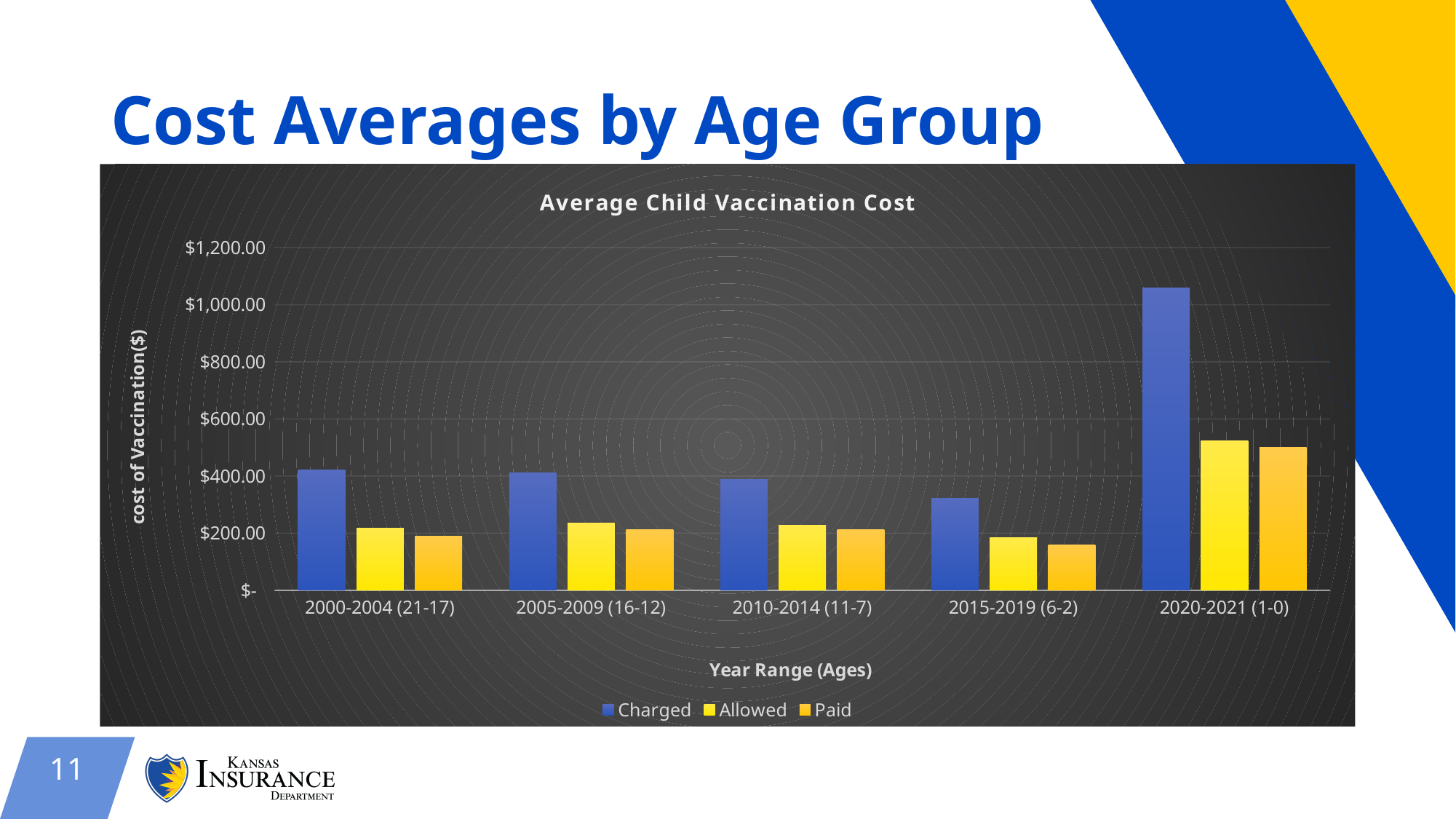
Is the Charged value for 2020-2021 (1-0) greater or less than $1,000.00? greater How many year-range categories are shown on the x axis? 5 Do the Charged values rise or fall from 2000-2004 (21-17) through 2015-2019 (6-2)? fall What is the title of the chart? Average Child Vaccination Cost For 2000-2004 (21-17), which is larger, the Charged value or the Allowed value? Charged Is the Allowed value for 2020-2021 (1-0) greater or less than $400.00? greater How many series does the legend list? 3 What kind of chart is shown on the slide? bar chart Which year range has the lowest Charged value? 2015-2019 (6-2) Which year range has the lowest Paid value? 2015-2019 (6-2) Which year range has the highest Charged value? 2020-2021 (1-0) Is the Paid value for 2015-2019 (6-2) greater or less than $200.00? less